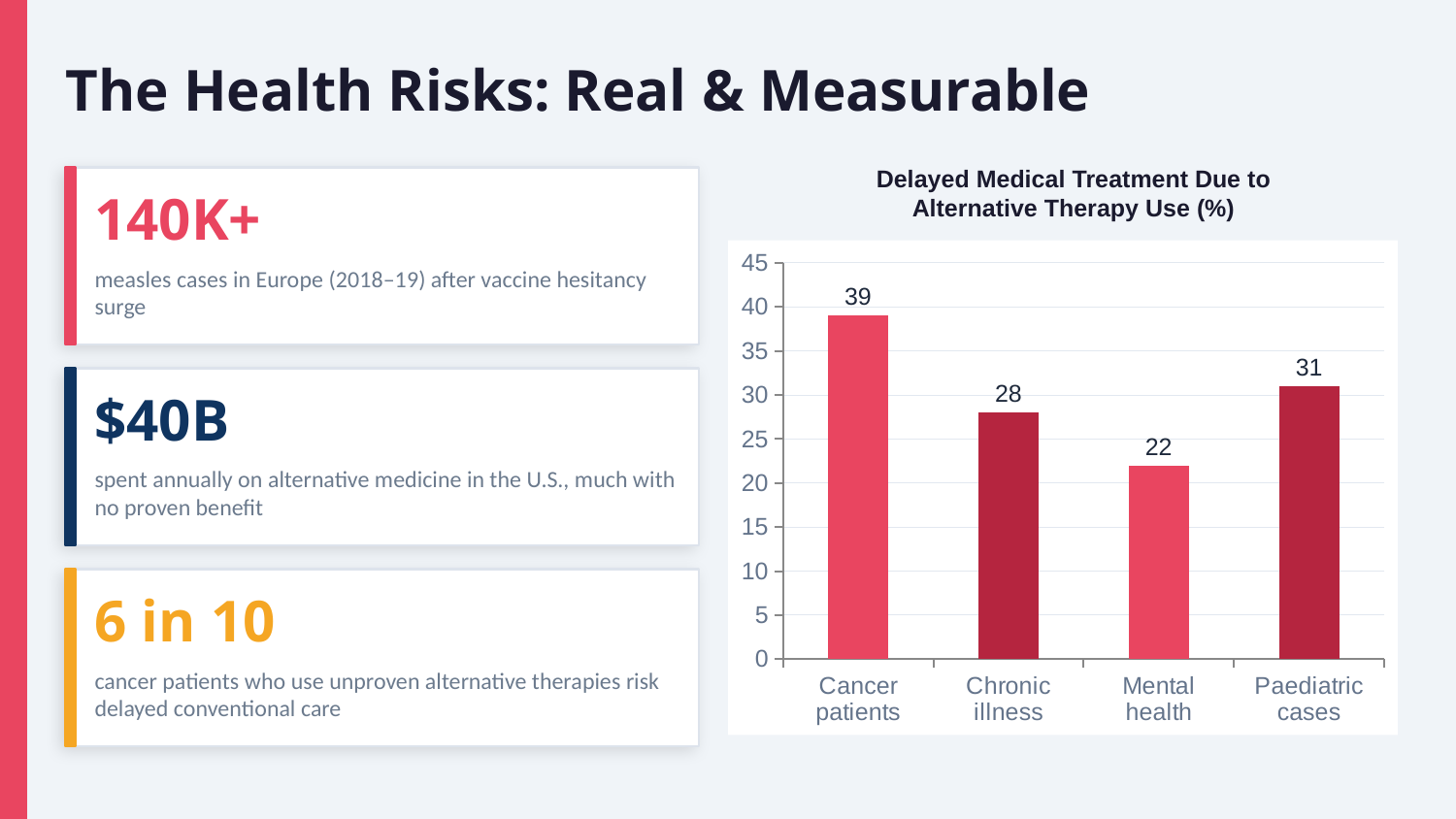
What kind of chart is shown on the slide? bar chart Which is larger, the value for Paediatric cases or the value for Chronic illness? Paediatric cases What is the value for Cancer patients in the chart? 39 What is the value for Chronic illness in the chart? 28 Which category has the lowest value in the chart? Mental health What is the title of the chart? Delayed Medical Treatment Due to Alternative Therapy Use (%) What is the value for Paediatric cases in the chart? 31 What is the value for Mental health in the chart? 22 What is the difference between the values for Cancer patients and Mental health? 17 How many categories are shown in the chart? 4 Is the value for Chronic illness greater or less than 30? less Which category has the highest value in the chart? Cancer patients